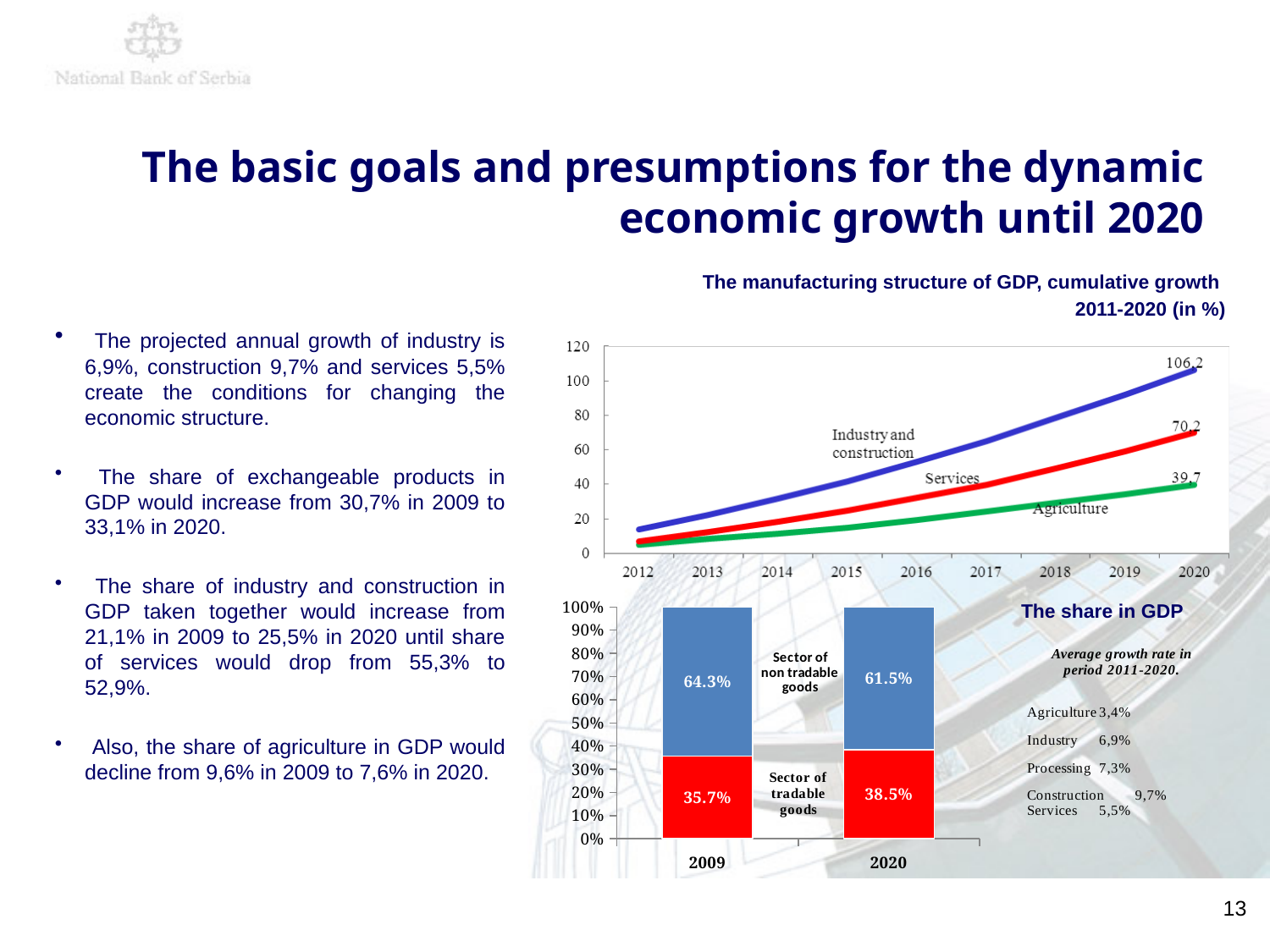
In the line chart titled 'The manufacturing structure of GDP, cumulative growth 2011-2020 (in %)', which series has the highest value in 2020? Industry and construction In the line chart titled 'The manufacturing structure of GDP, cumulative growth 2011-2020 (in %)', how many years are shown on the x axis? 9 In the line chart titled 'The manufacturing structure of GDP, cumulative growth 2011-2020 (in %)', what is the difference between the 2020 values for Industry and construction and Services? 36 In the line chart titled 'The manufacturing structure of GDP, cumulative growth 2011-2020 (in %)', is the value for Industry and construction in 2016 greater or less than 40? greater In the line chart titled 'The manufacturing structure of GDP, cumulative growth 2011-2020 (in %)', what is the value for Agriculture in 2020? 39.7 In the line chart titled 'The manufacturing structure of GDP, cumulative growth 2011-2020 (in %)', what is the value for Services in 2020? 70.2 In the line chart titled 'The manufacturing structure of GDP, cumulative growth 2011-2020 (in %)', what is the value for Industry and construction in 2020? 106.2 In the bar chart titled 'The share in GDP', what is the share of the sector of non tradable goods in 2009? 64.3% In the line chart titled 'The manufacturing structure of GDP, cumulative growth 2011-2020 (in %)', do the values for Services rise or fall from 2012 to 2020? rise In the line chart titled 'The manufacturing structure of GDP, cumulative growth 2011-2020 (in %)', which series has the lowest value in 2020? Agriculture In the bar chart titled 'The share in GDP', what kind of chart is it? stacked bar chart In the bar chart titled 'The share in GDP', what is the share of the sector of tradable goods in 2020? 38.5%